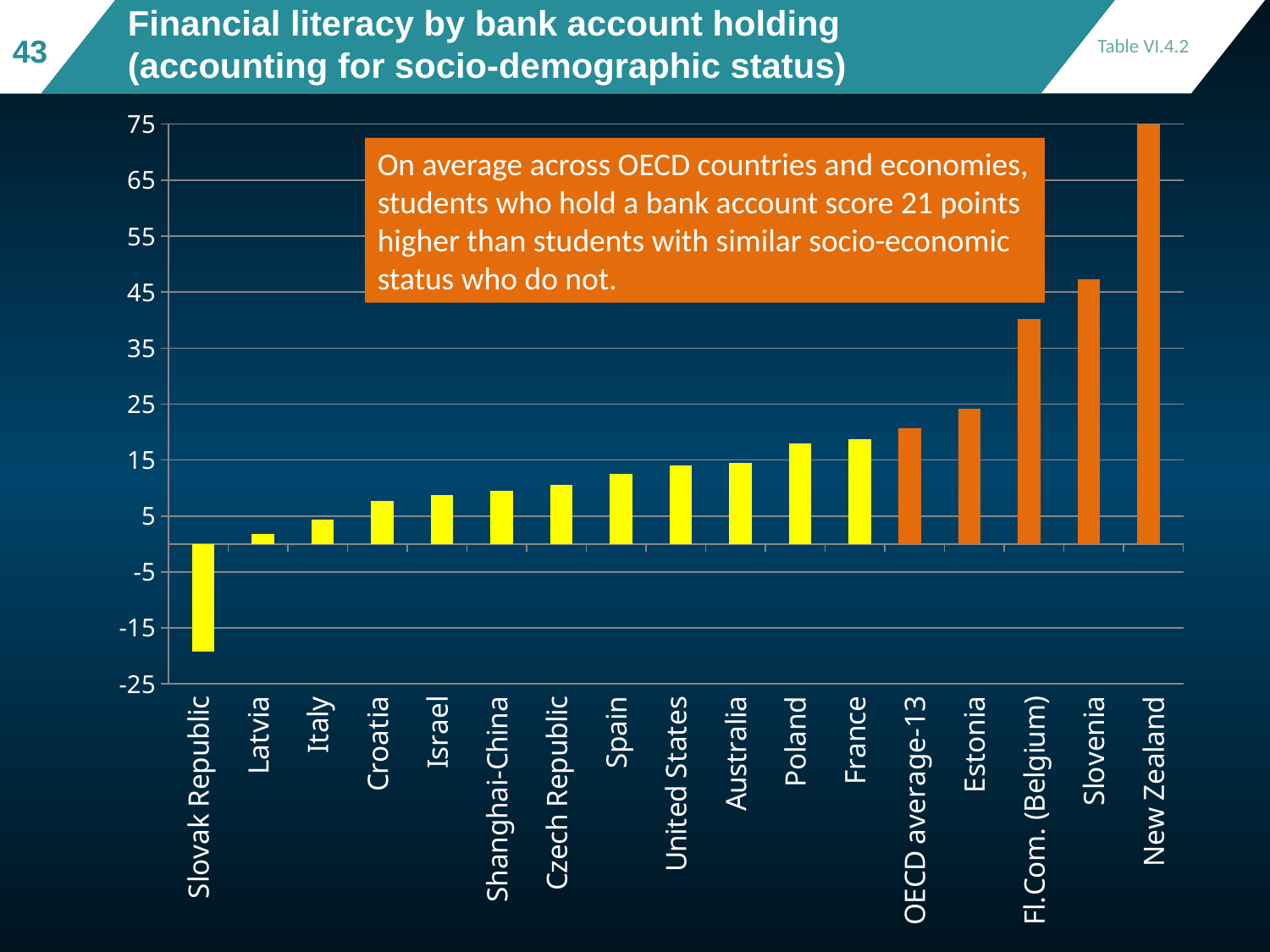
Is the value for Fl.Com. (Belgium) greater or less than 35? greater Which category has the lowest value? Slovak Republic Which category has the highest value? New Zealand How many categories are plotted along the x axis? 17 What kind of chart is shown on the slide? bar chart Which has the larger value, Slovenia or Estonia? Slovenia Is the value for Estonia greater or less than 15? greater Is the value for Slovak Republic greater or less than -15? less What is the title of the chart on the slide? Financial literacy by bank account holding (accounting for socio-demographic status) Do the values generally rise or fall moving from left to right along the x axis? rise